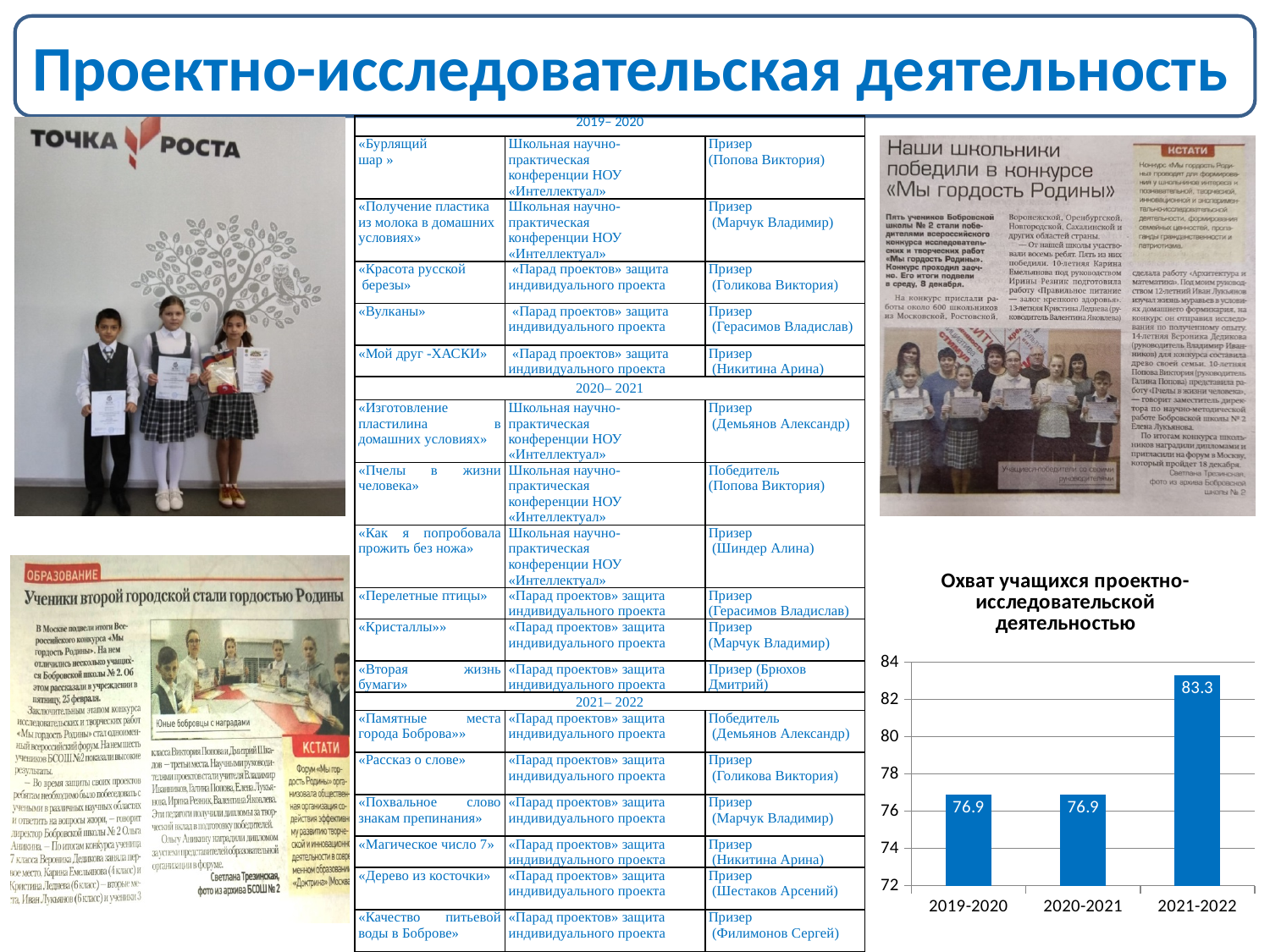
What is the value for 2021-2022 in the chart 'Охват учащихся проектно-исследовательской деятельностью'? 83.3 Which year has the highest value in the chart? 2021-2022 Is the value for 2021-2022 greater or less than 80? greater What is the title of the chart on the slide? Охват учащихся проектно-исследовательской деятельностью How many categories are shown on the x axis of the chart? 3 What is the value for 2020-2021 in the chart? 76.9 Which is larger, the value for 2021-2022 or the value for 2019-2020? 2021-2022 Is the value for 2019-2020 greater or less than 78? less What is the value for 2019-2020 in the chart? 76.9 Do the values rise or fall from 2020-2021 to 2021-2022? rise What is the difference between the values for 2021-2022 and 2020-2021? 6.4 What kind of chart is shown on the slide? bar chart